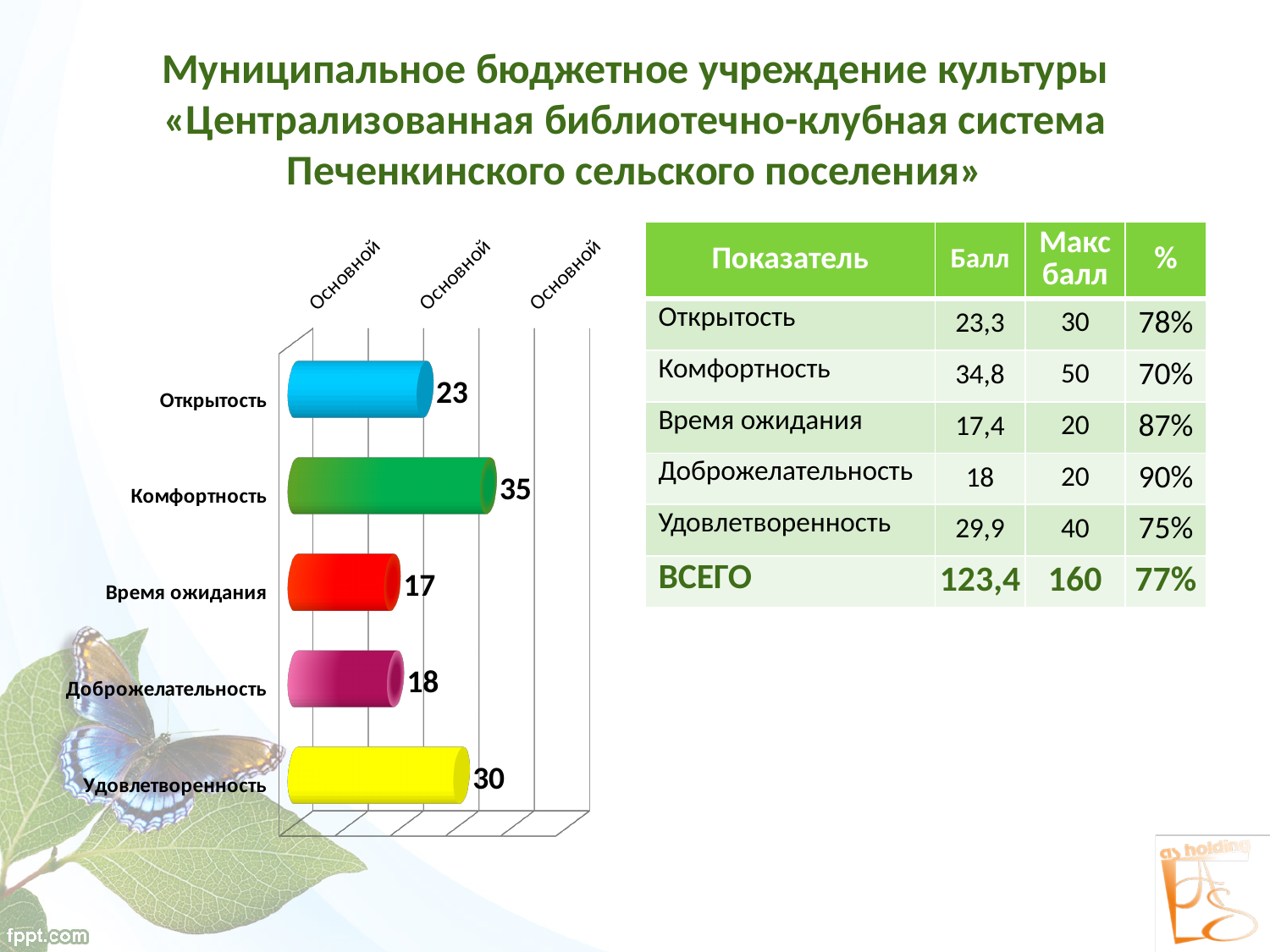
Which is larger in the bar chart, the value for Доброжелательность or the value for Время ожидания? Доброжелательность What is the difference between the values for Комфортность and Открытость in the bar chart? 12 What colour is the bar for Удовлетворенность in the bar chart? Yellow Which category has the lowest value in the bar chart? Время ожидания What value is shown for Время ожидания in the bar chart? 17 What is the difference between the values for Удовлетворенность and Доброжелательность in the bar chart? 12 What value is shown for Открытость in the bar chart? 23 What value is shown for Комфортность in the bar chart? 35 What value is shown for Удовлетворенность in the bar chart? 30 What type of chart is shown on the slide? Bar chart How many categories are shown in the bar chart? 5 Which category has the highest value in the bar chart? Комфортность